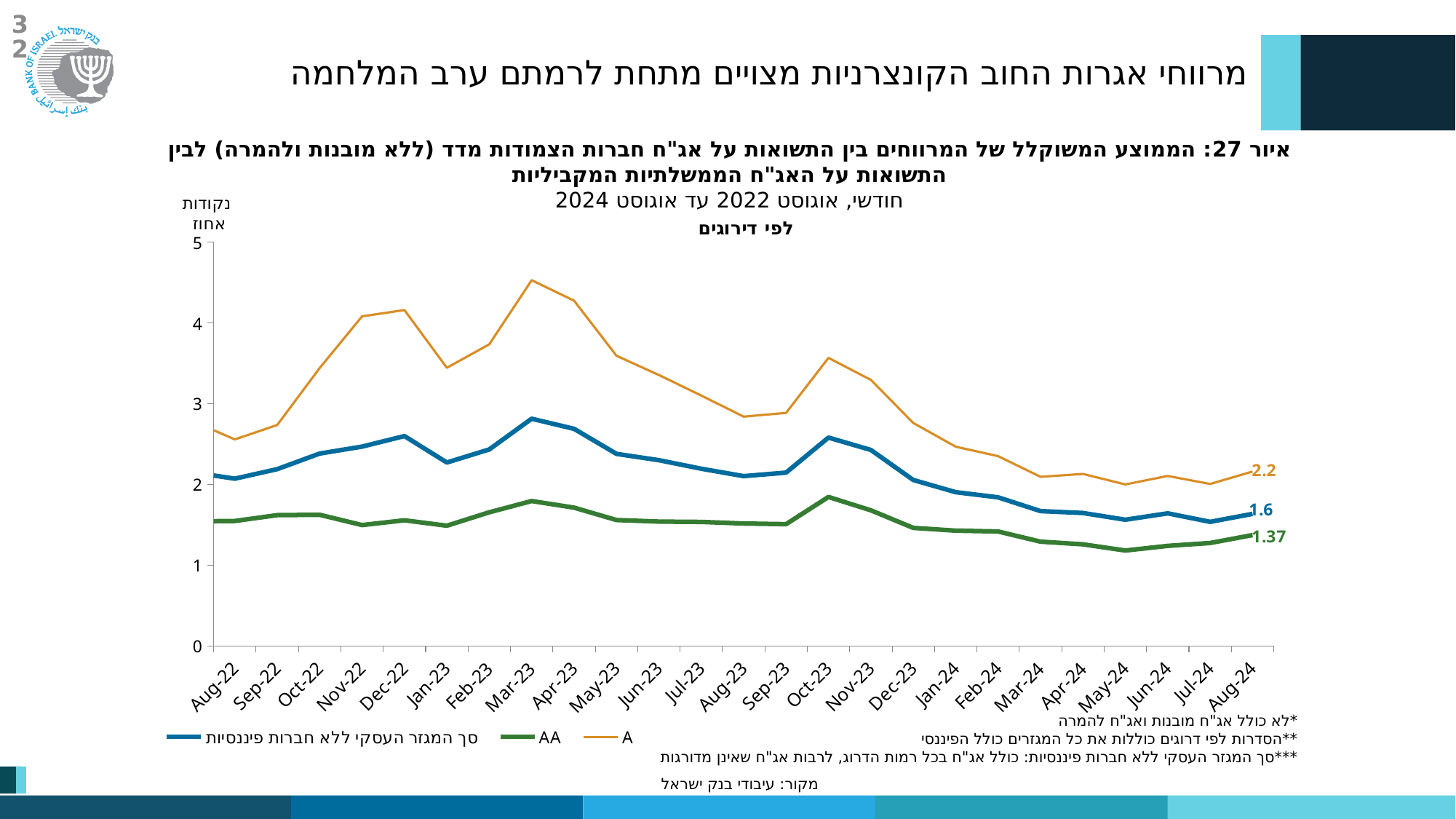
At Aug-24, which is larger: the A series or the 'סך המגזר העסקי ללא חברות פיננסיות' series? A Which series has the highest value at Aug-24? A Is the value for the AA series at May-24 greater or less than 1.5? less Does the A series rise or fall from Oct-23 to Mar-24? fall Which series has the lowest value at Aug-24? AA Is the value for the A series at Mar-23 greater or less than 4? greater What is the value of the A series at Aug-24? 2.2 What is the value of the AA series at Aug-24? 1.37 How many series does the legend list? 3 What is the value of the 'סך המגזר העסקי ללא חברות פיננסיות' series at Aug-24? 1.6 What is the difference between the A series and the AA series at Aug-24? 0.83 What kind of chart is shown on the slide? line chart